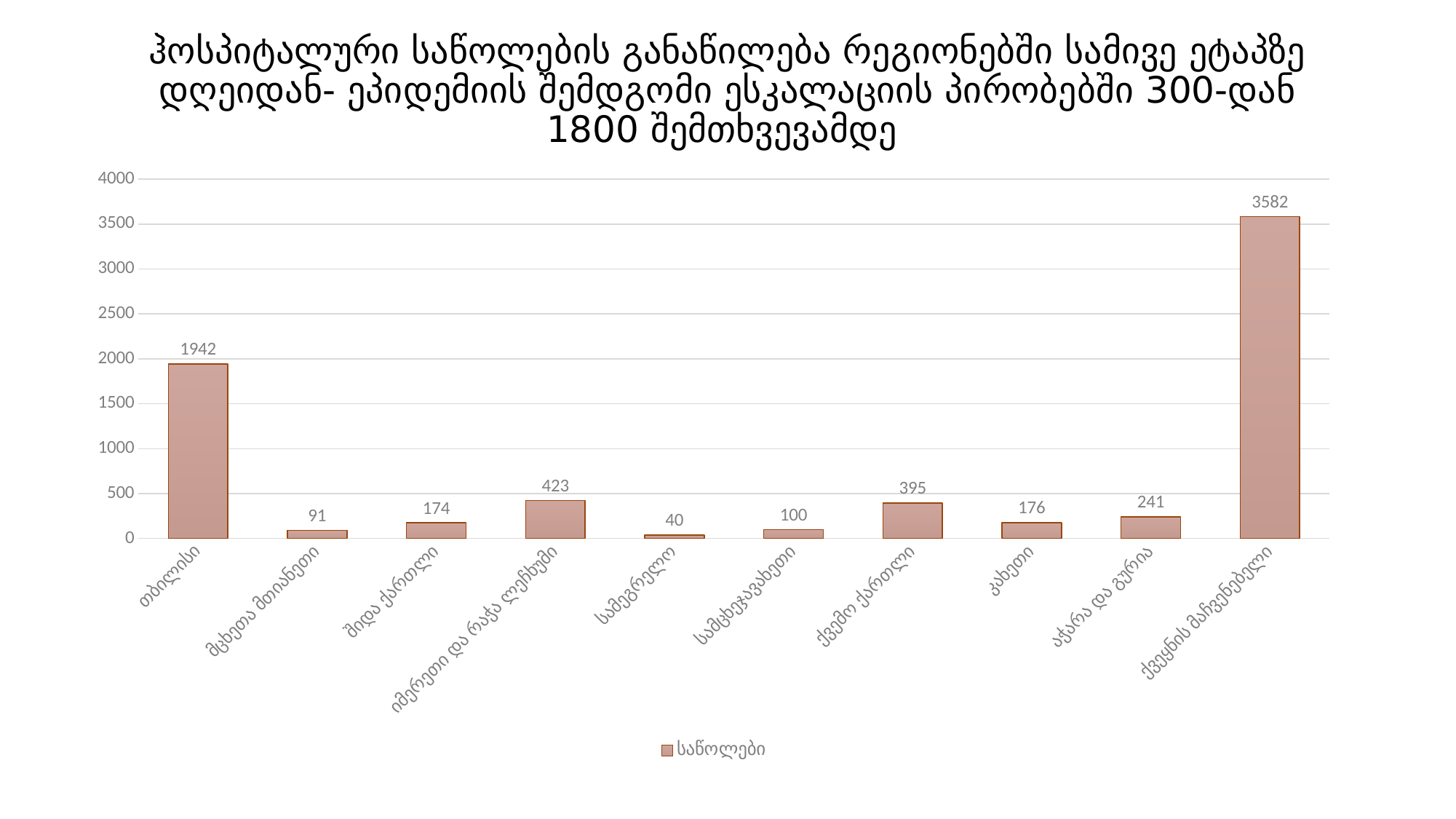
What is the difference between the values for იმერეთი და რაჭა ლეჩხუმი and ქვემო ქართლი? 28 Is the value for თბილისი greater or less than 1500? greater Which category has the highest value? ქვეყნის მაჩვენებელი What is the value for თბილისი? 1942 How many series does the legend list? 1 What kind of chart is shown on the slide? bar chart What is the value for აჭარა და გურია? 241 Which category has the lowest value? სამეგრელო How many categories are shown on the x axis? 10 Which is larger, the value for კახეთი or the value for შიდა ქართლი? კახეთი What is the difference between the values for ქვეყნის მაჩვენებელი and თბილისი? 1640 What is the value for სამეგრელო? 40